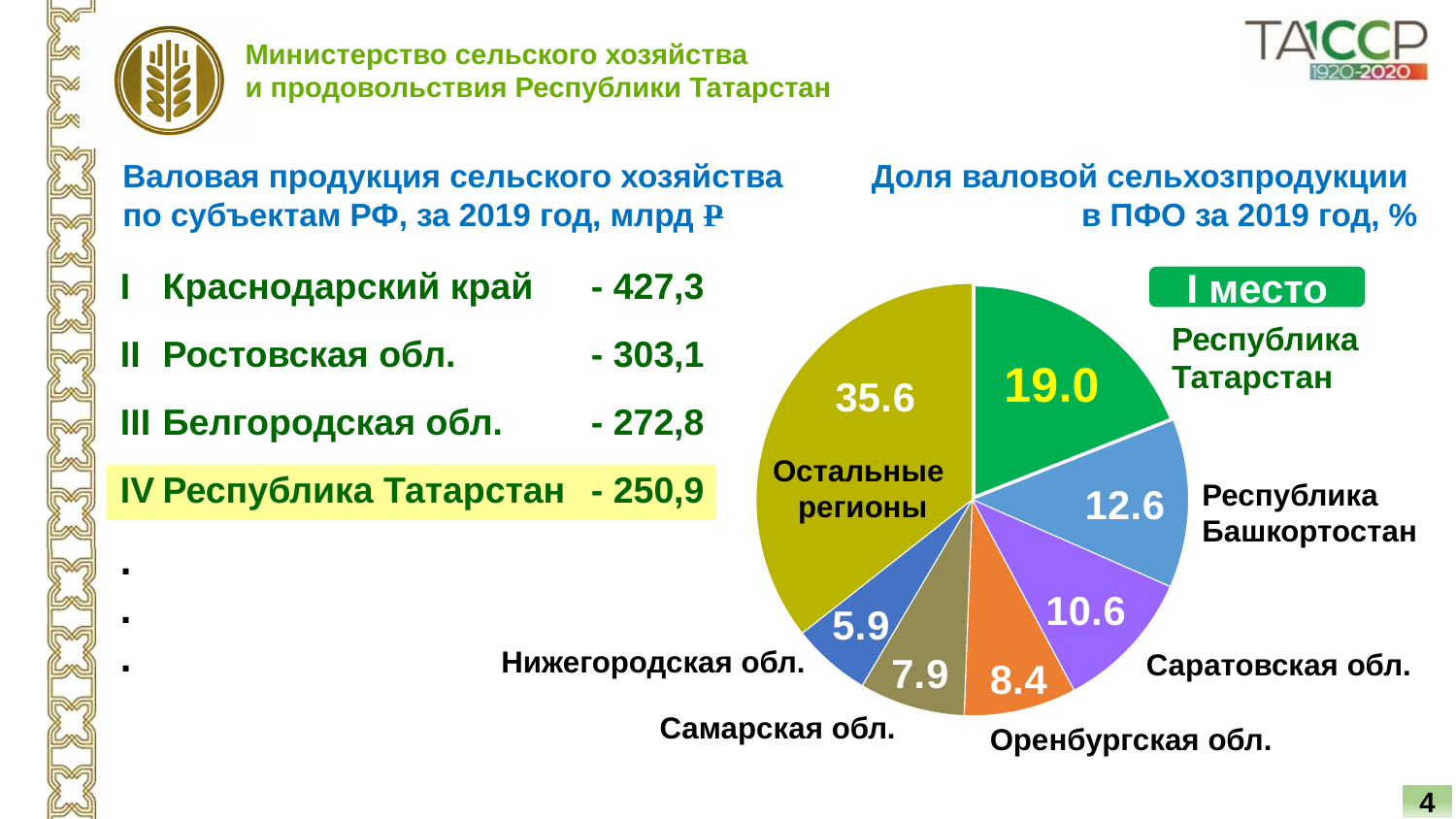
What is the share for Самарская обл. in the pie chart? 7.9 How many slices does the pie chart have? 7 What is the share for Республика Башкортостан in the pie chart? 12.6 What type of chart is shown on the slide? Pie chart What is the share for Оренбургская обл. in the pie chart? 8.4 What is the difference between the shares of Республика Татарстан and Республика Башкортостан in the pie chart? 6.4 What is the share for Нижегородская обл. in the pie chart? 5.9 Which has a larger share in the pie chart, Оренбургская обл. or Самарская обл.? Оренбургская обл. What is the share for Республика Татарстан in the pie chart? 19.0 Which slice of the pie chart is the largest? Остальные регионы Which named region has the smallest slice in the pie chart? Нижегородская обл. What is the share for Саратовская обл. in the pie chart? 10.6